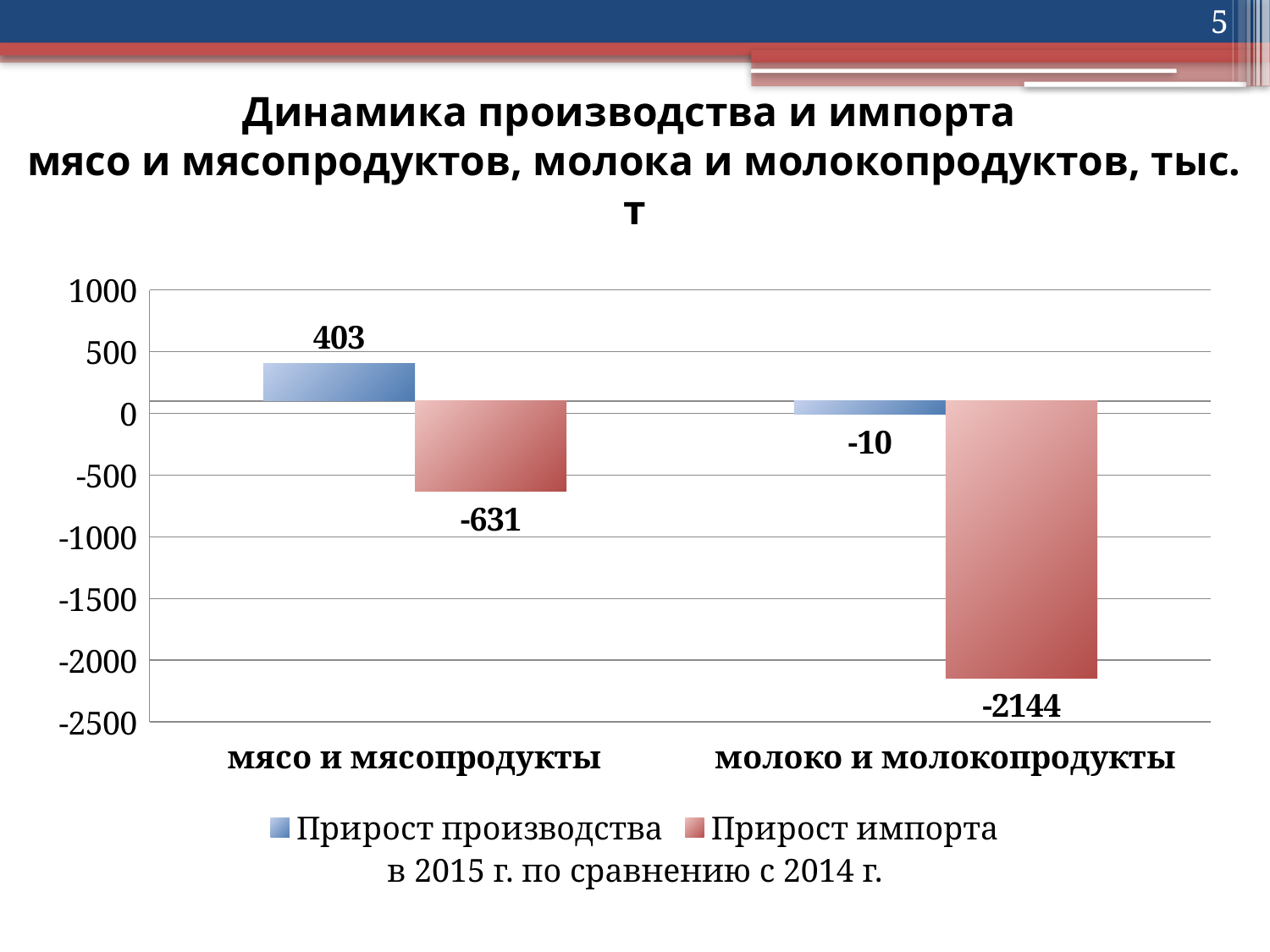
What kind of chart is shown on the slide? bar chart What is the value of Прирост производства for мясо и мясопродукты? 403 What is the difference between Прирост производства and Прирост импорта for мясо и мясопродукты? 1034 Which category has the lowest Прирост импорта value? молоко и молокопродукты Which category has the highest Прирост производства value? мясо и мясопродукты What is the value of Прирост импорта for мясо и мясопродукты? -631 Which is larger: Прирост производства for мясо и мясопродукты or Прирост производства for молоко и молокопродукты? мясо и мясопродукты What is the value of Прирост производства for молоко и молокопродукты? -10 How many series does the legend list? 2 How many categories are shown on the x axis? 2 What is the value of Прирост импорта for молоко и молокопродукты? -2144 What is the difference between the Прирост импорта values for мясо и мясопродукты and молоко и молокопродукты? 1513